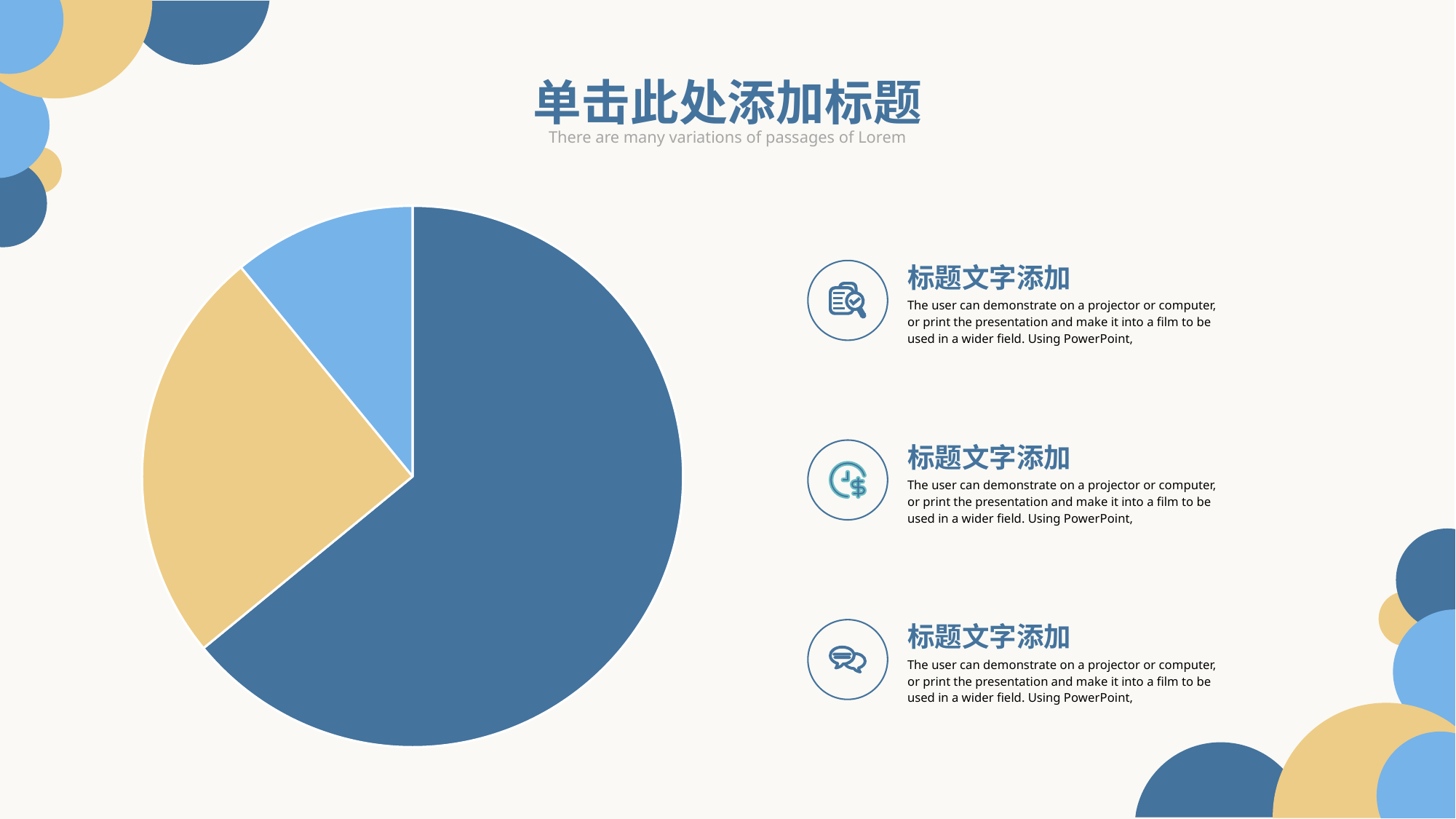
Which is larger in the pie chart, the dark blue slice or the yellow slice? the dark blue slice What three colours are used for the slices of the pie chart? dark blue, yellow and light blue Does the pie chart display a legend? No Which is larger in the pie chart, the yellow slice or the light blue slice? the yellow slice Which slice of the pie chart is the smallest? the light blue slice Which slice of the pie chart is the largest? the dark blue slice What kind of chart is shown on the slide? pie chart How many slices does the pie chart have? 3 Does the dark blue slice take up more or less than half of the pie chart? more